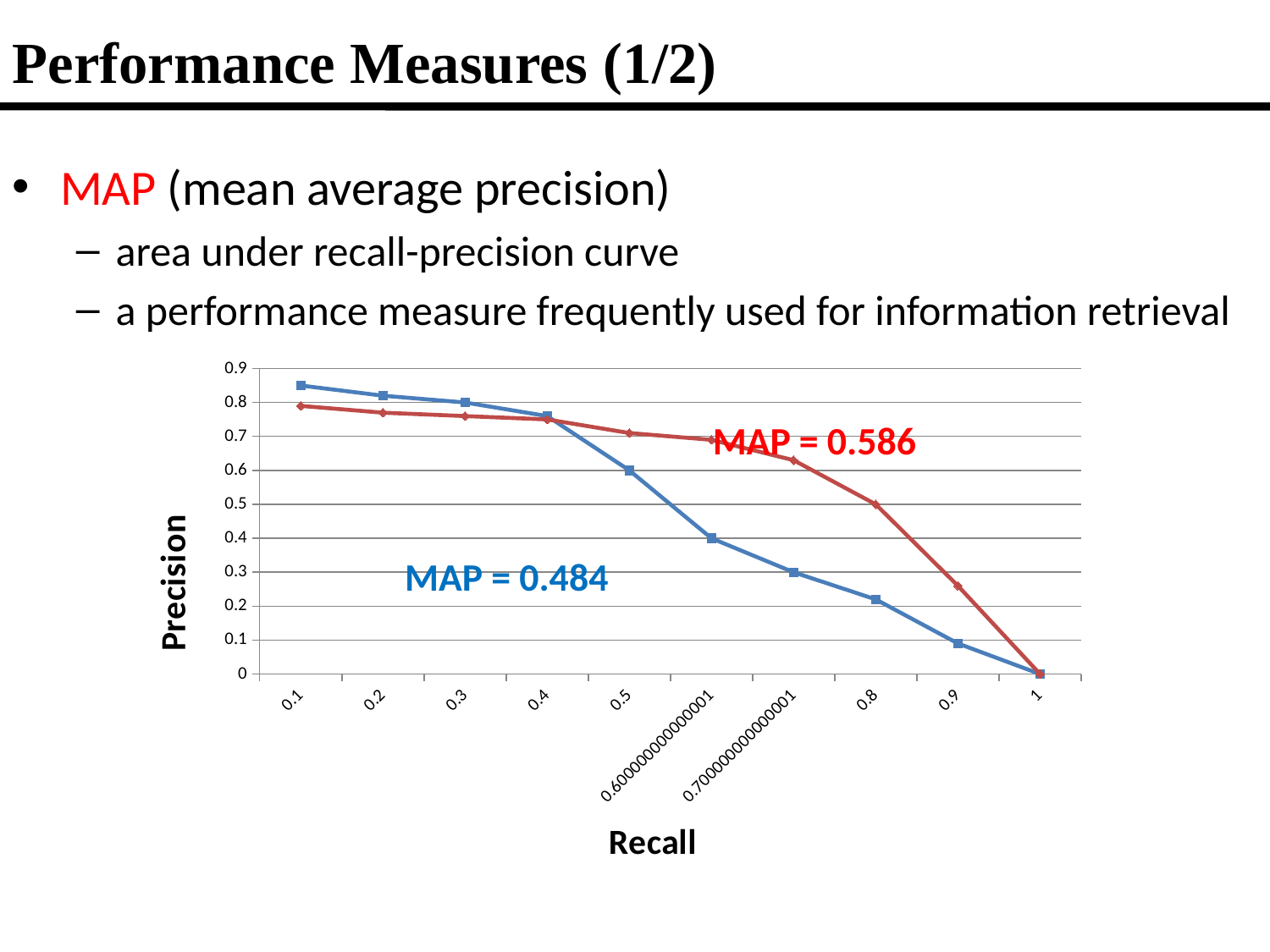
Which line has the higher MAP value, the red line or the blue line? red line What is the MAP value printed next to the blue line? 0.484 What is the precision of both lines at recall 1? 0 What kind of chart is shown on the slide? line chart Do the precision values rise or fall as recall increases along the x axis? fall Is the precision of the blue line at recall 0.1 greater or less than 0.8? greater At recall 0.8, which line has the higher precision, the red line or the blue line? red line How many recall values are marked along the x axis? 10 What is the title of the y axis? Precision What is the difference between the two MAP values printed on the chart? 0.102 What is the MAP value printed next to the red line? 0.586 Is the precision of the red line at recall 0.9 greater or less than 0.2? greater